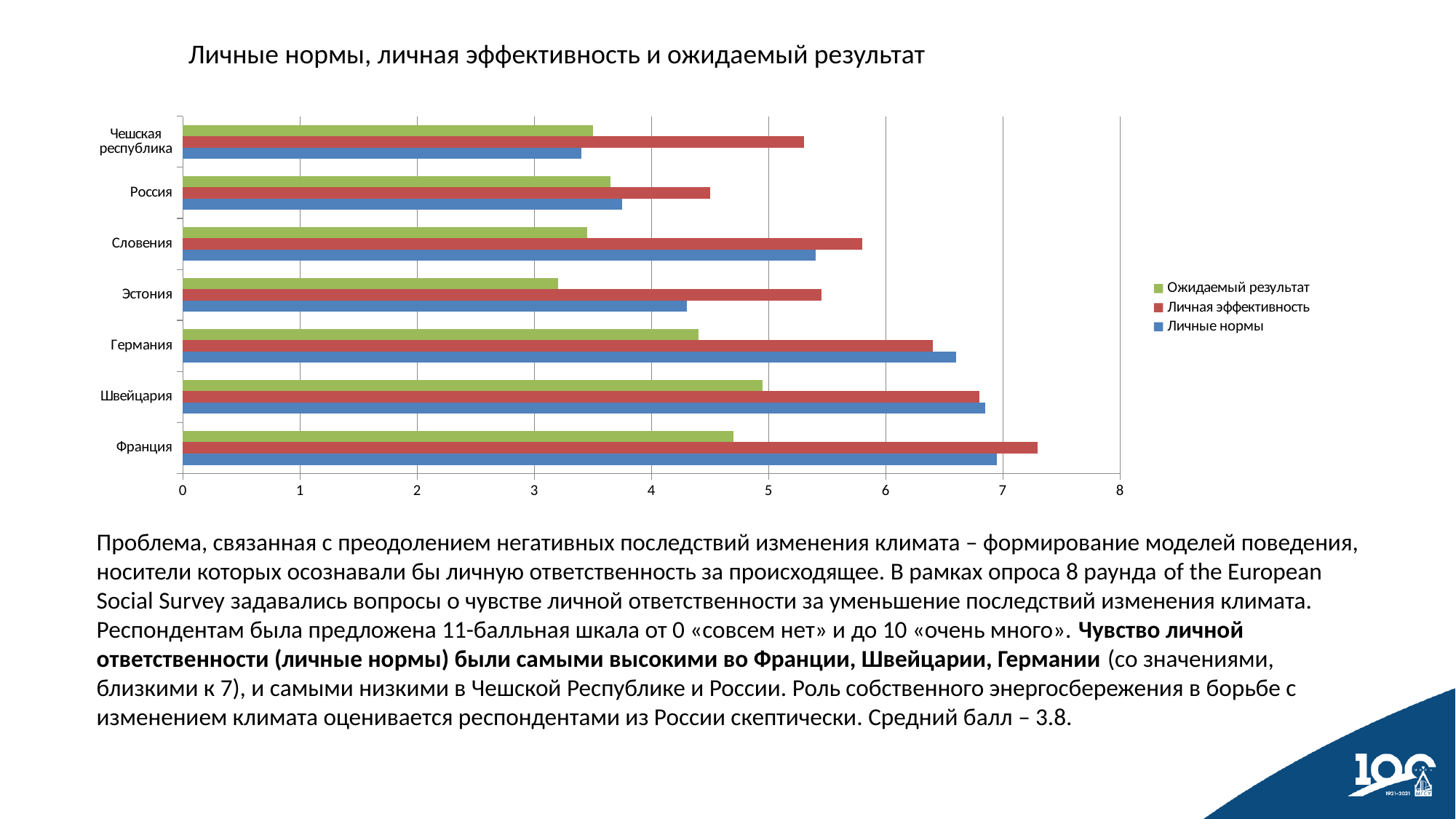
How many series does the legend list? 3 Is the value for Личные нормы in Германия greater or less than 6? greater Which country has the highest value for Личная эффективность? Франция Is the value for Личная эффективность in Россия greater or less than 5? less Is the value for Личная эффективность in Франция greater or less than 7? greater Which country has the lowest value for Личная эффективность? Россия What is the title of the chart? Личные нормы, личная эффективность и ожидаемый результат How many countries are shown on the chart? 7 Which is larger: Личные нормы for Словения or Личные нормы for Россия? Словения Which series is shown in green in the legend? Ожидаемый результат What kind of chart is shown on the slide? bar chart